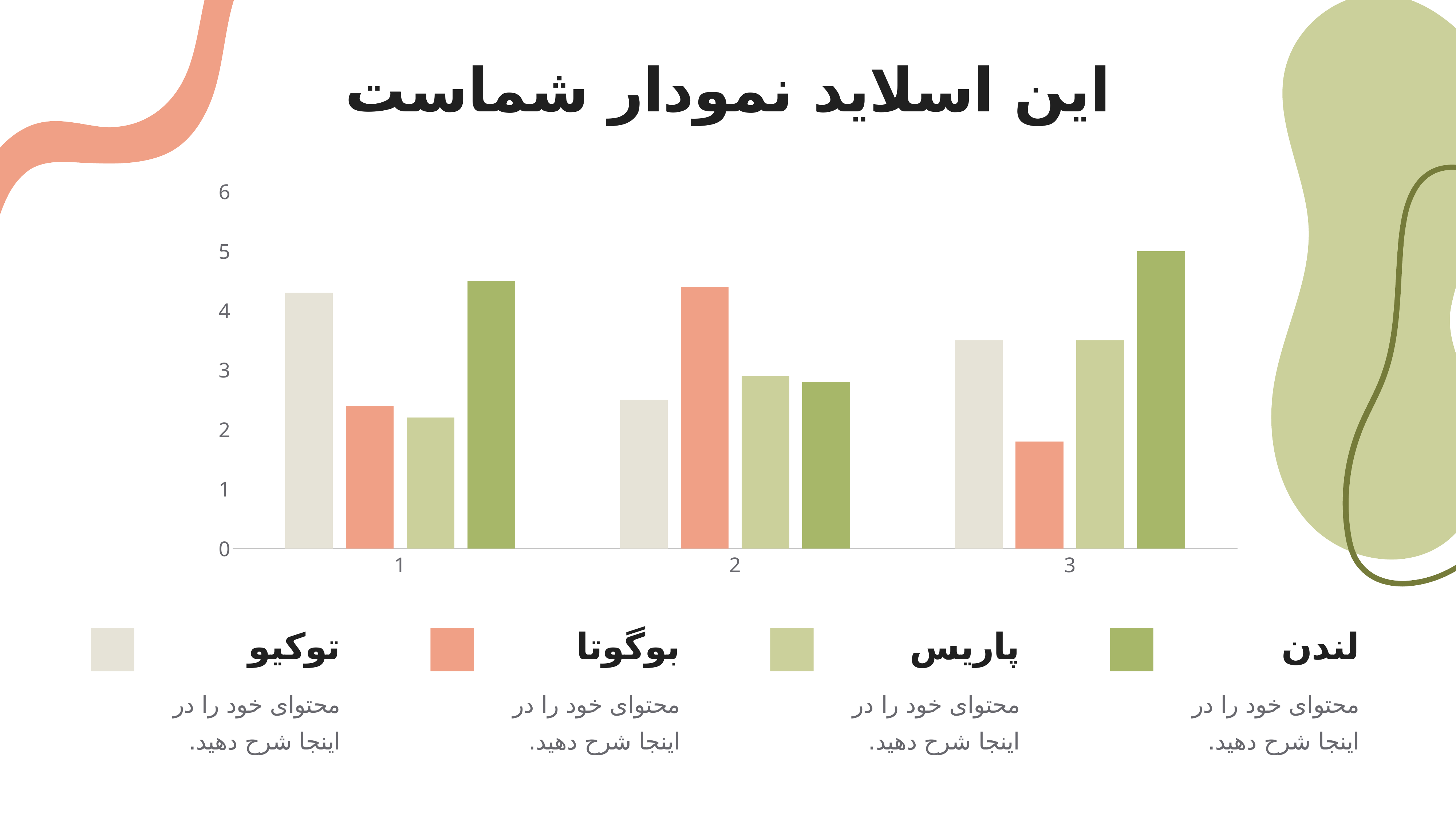
What kind of chart is shown on the slide? bar chart Which series has the highest value in category 2? بوگوتا In category 1, which is larger: the value for توکیو or the value for پاریس? توکیو Is the value for توکیو in category 2 greater or less than 3? less Do the values for پاریس rise or fall from category 1 to category 3? rise Is the value for بوگوتا in category 3 greater or less than 2? less Is the value for بوگوتا in category 2 greater or less than 4? greater How many series does the chart's legend list? 4 Which series is shown in the salmon/orange colour in the legend? بوگوتا How many categories are shown on the x axis of the chart? 3 Which series has the lowest value in category 3? بوگوتا